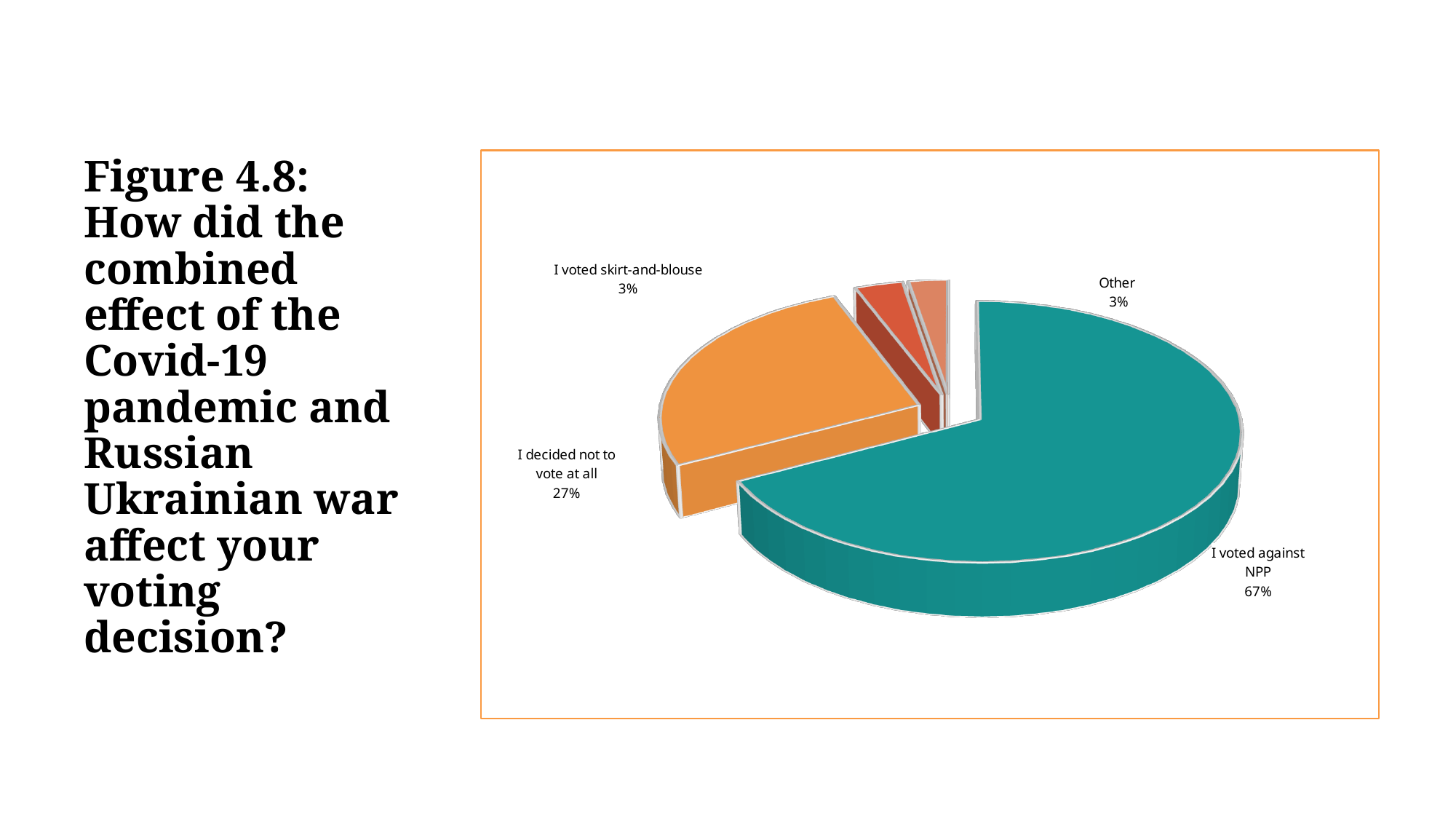
What share of respondents said they decided not to vote at all? 27% Which response has the largest share of the pie? I voted against NPP What kind of chart is shown on the slide? Pie chart What share of respondents said they voted against NPP? 67% What is the combined share of 'I voted skirt-and-blouse' and 'Other'? 6% What is the difference in percentage points between 'I voted against NPP' and 'I decided not to vote at all'? 40 percentage points How many slices does the pie chart have? 4 What share of respondents said they voted skirt-and-blouse? 3% What is the figure number given in the slide title? Figure 4.8 What share of respondents is labelled Other? 3% Which is larger: the share for 'I decided not to vote at all' or the share for 'I voted skirt-and-blouse'? I decided not to vote at all What colour is the slice for 'I voted against NPP'? Teal